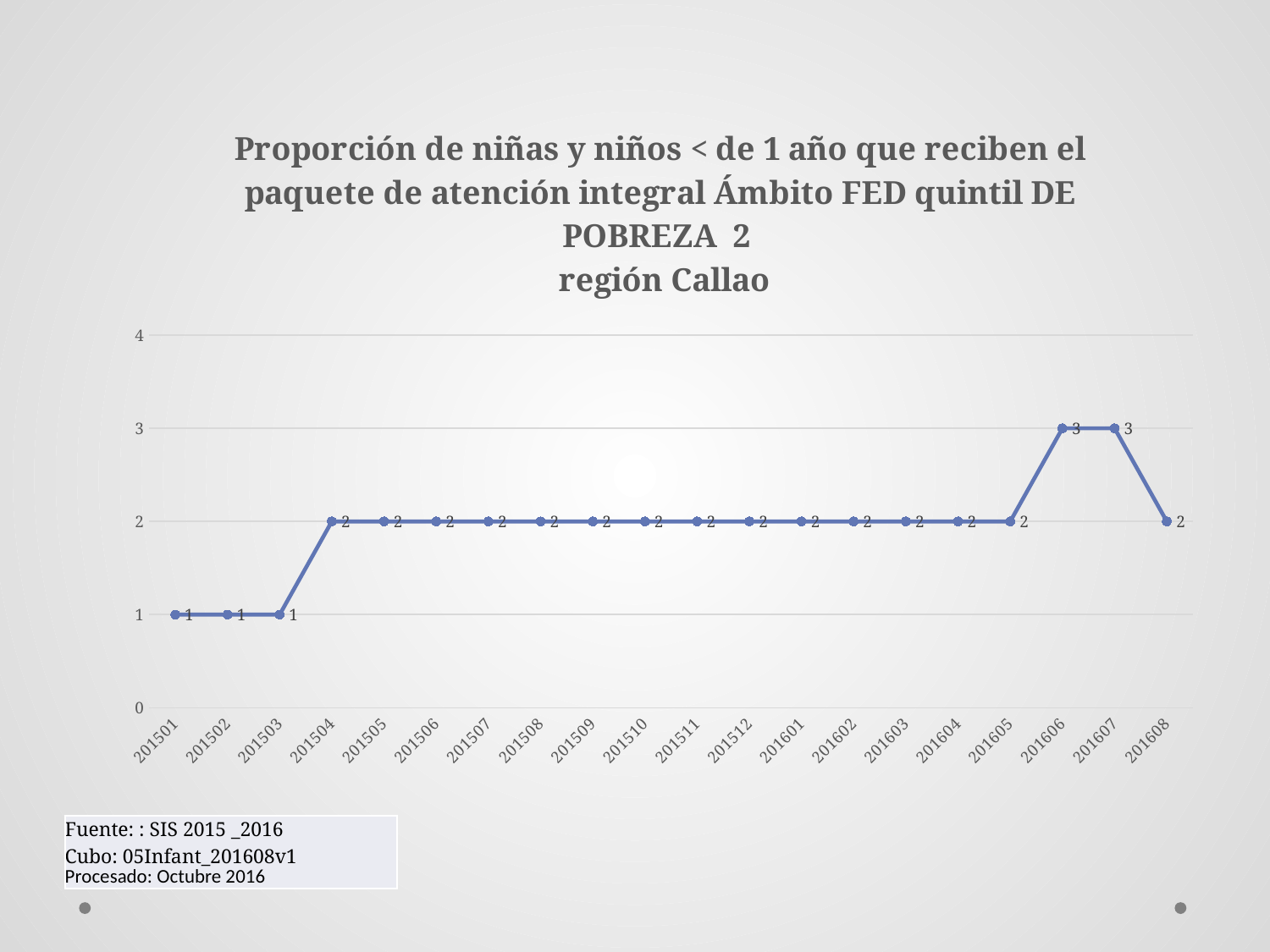
What is the value for 201608? 2 What kind of chart is shown on the slide? line chart How many periods are plotted along the x axis? 20 What is the difference between the value for 201607 and the value for 201503? 2 Which is the first period in which the value reaches 3? 201606 What is the value for 201606? 3 Which region is named in the chart title? Callao Which is larger, the value for 201504 or the value for 201502? 201504 What is the lowest value plotted on the chart? 1 What is the value for 201501? 1 What is the value for 201510? 2 Does the value rise or fall between 201607 and 201608? fall